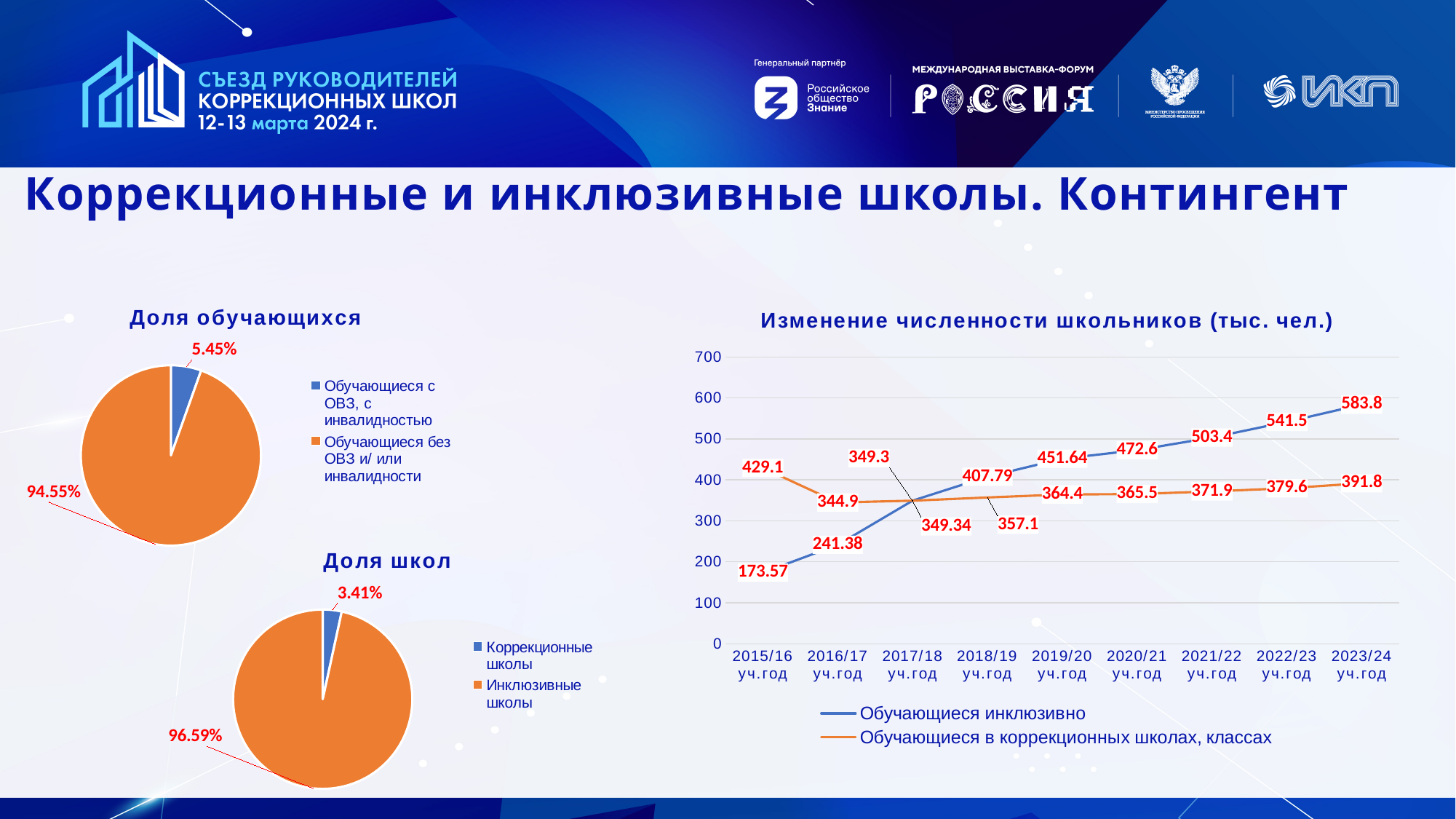
On the line chart 'Изменение численности школьников (тыс. чел.)', which series has the larger value in 2015/16 уч.год? Обучающиеся в коррекционных школах, классах On the line chart 'Изменение численности школьников (тыс. чел.)', what is the value for 'Обучающиеся в коррекционных школах, классах' in 2015/16 уч.год? 429.1 On the pie chart 'Доля школ', what share is 'Инклюзивные школы'? 96.59% On the line chart 'Изменение численности школьников (тыс. чел.)', what is the difference between the two series in 2023/24 уч.год? 192 On the line chart 'Изменение численности школьников (тыс. чел.)', how many series does the legend list? 2 On the line chart 'Изменение численности школьников (тыс. чел.)', how many school years are shown on the x axis? 9 What kind of chart is 'Изменение численности школьников (тыс. чел.)'? line chart On the line chart 'Изменение численности школьников (тыс. чел.)', what is the value for 'Обучающиеся инклюзивно' in 2023/24 уч.год? 583.8 On the line chart 'Изменение численности школьников (тыс. чел.)', in which school year is the 'Обучающиеся в коррекционных школах, классах' series highest? 2015/16 уч.год On the line chart 'Изменение численности школьников (тыс. чел.)', does the 'Обучающиеся инклюзивно' series rise or fall from 2015/16 to 2023/24? rise What kind of chart is 'Доля школ'? pie chart On the pie chart 'Доля обучающихся', what share is 'Обучающиеся с ОВЗ, с инвалидностью'? 5.45%